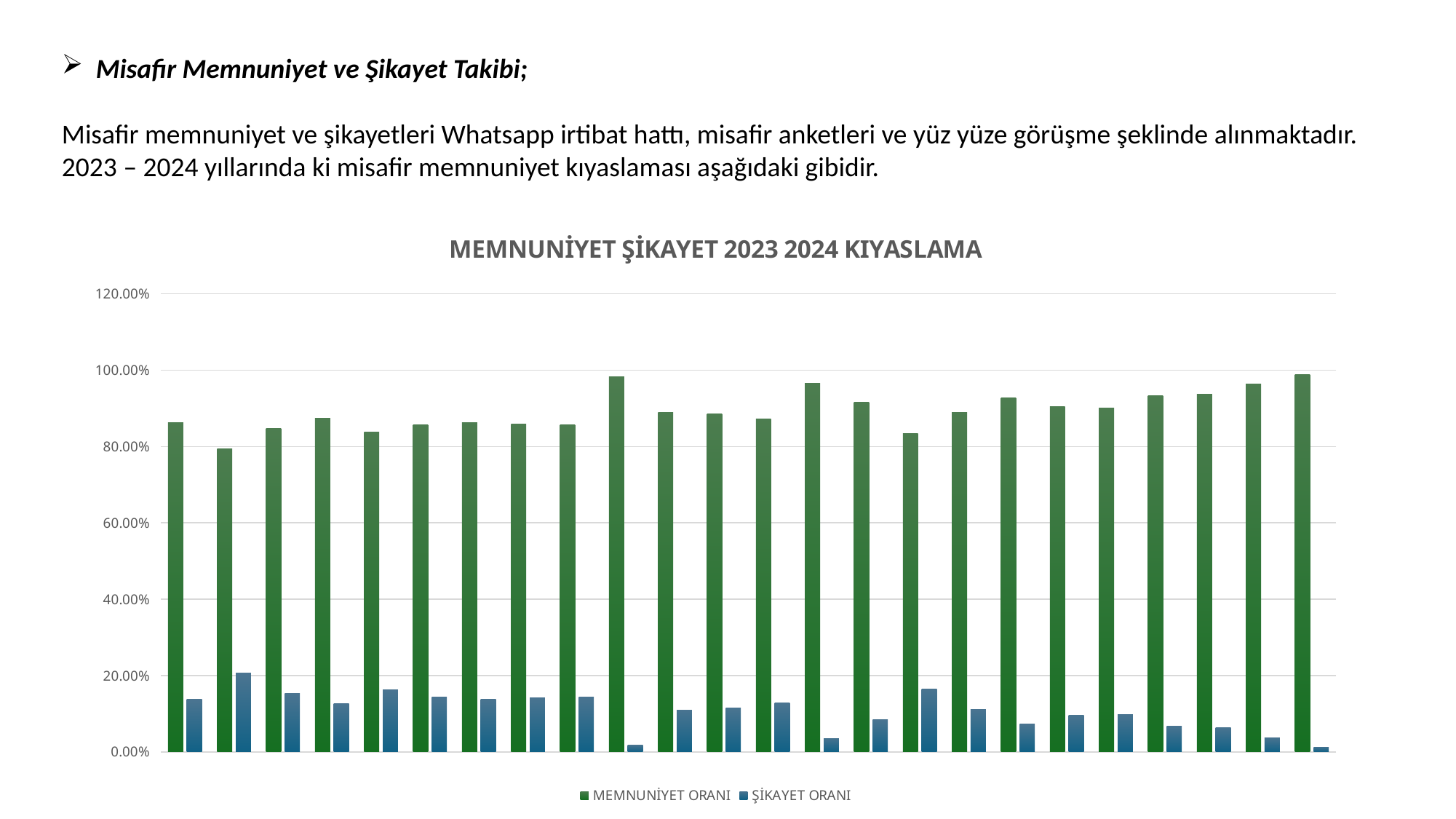
Which two series are listed in the chart legend? MEMNUNİYET ORANI and ŞİKAYET ORANI How many series does the legend list? 2 How many pairs of bars (categories) are plotted in the chart? 24 What kind of chart is shown on the slide? bar chart Which series has the higher values throughout the chart, MEMNUNİYET ORANI or ŞİKAYET ORANI? MEMNUNİYET ORANI Is the leftmost MEMNUNİYET ORANI bar greater or less than 80%? greater What is the highest value shown on the vertical axis? 120.00% Are all ŞİKAYET ORANI bars greater or less than 40%? less Is the rightmost ŞİKAYET ORANI bar greater or less than 20%? less What is the title of the chart? MEMNUNİYET ŞİKAYET 2023 2024 KIYASLAMA